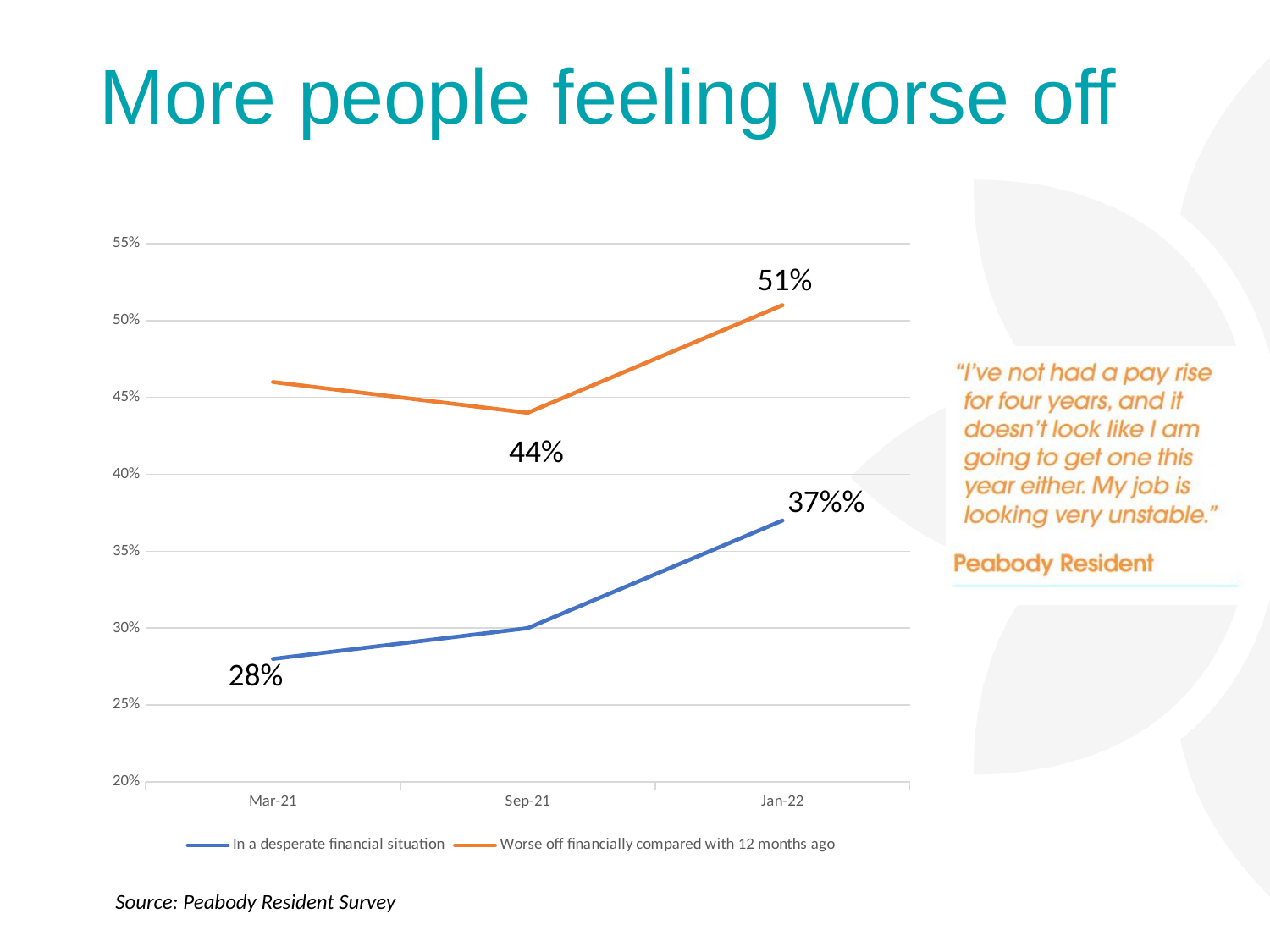
At which time point is 'Worse off financially compared with 12 months ago' highest? Jan-22 Is the value for 'In a desperate financial situation' in Sep-21 greater or less than 35%? less How many time points are shown on the x axis of the chart? 3 Does the 'In a desperate financial situation' line rise or fall from Mar-21 to Jan-22? Rise By how many percentage points did 'Worse off financially compared with 12 months ago' change between Sep-21 and Jan-22? 7 percentage points What is the value for 'Worse off financially compared with 12 months ago' in Jan-22? 51% Is the value for 'Worse off financially compared with 12 months ago' in Mar-21 greater or less than 40%? greater In Jan-22, which series has the higher value? Worse off financially compared with 12 months ago What is the value for 'Worse off financially compared with 12 months ago' in Sep-21? 44% What is the value for 'In a desperate financial situation' in Mar-21? 28% How many series does the chart's legend list? 2 What kind of chart is shown on the slide? Line chart